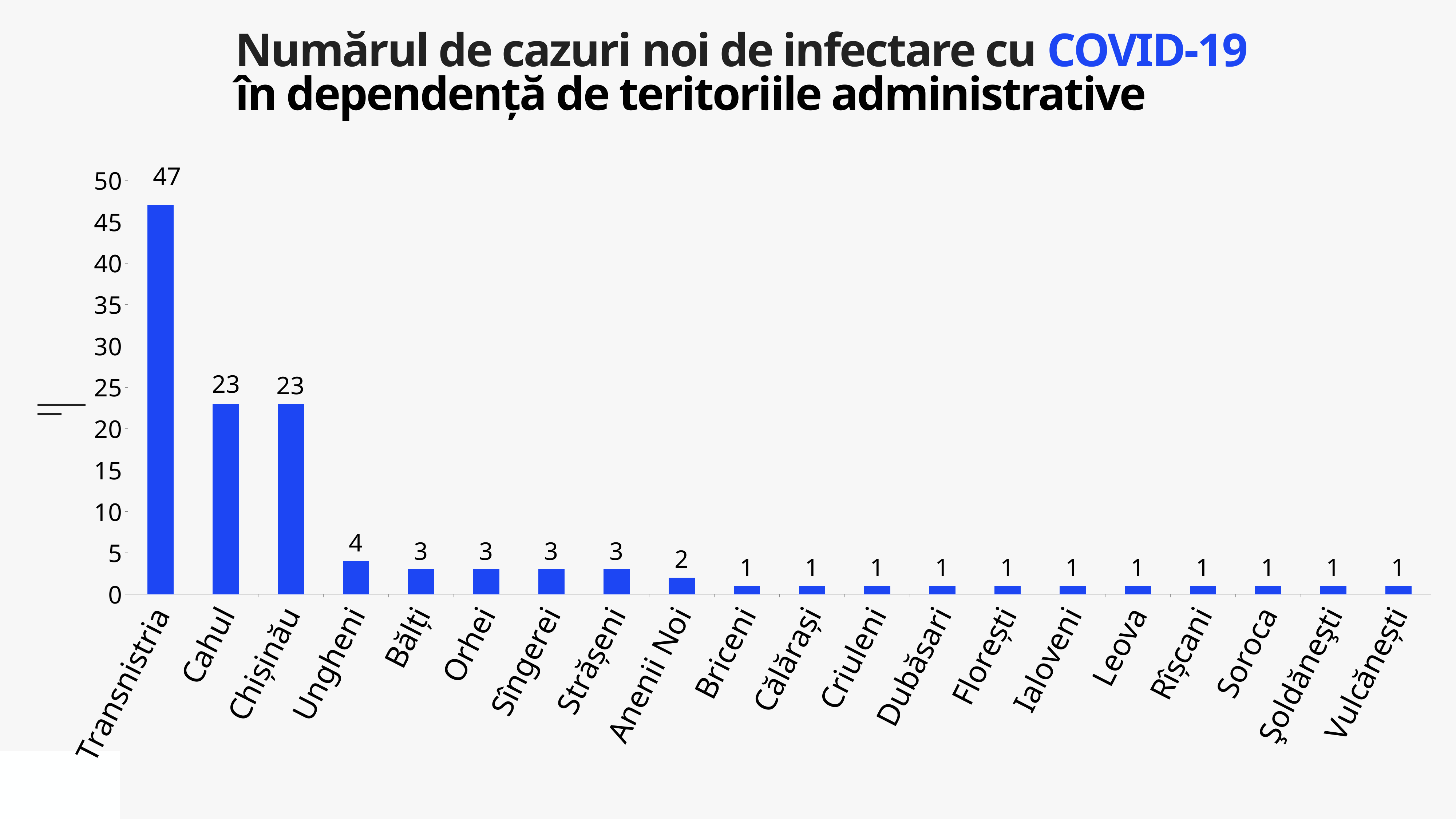
What is the value for Transnistria? 47 What is the value for Anenii Noi? 2 What kind of chart is shown on the slide? bar chart Is the value for Transnistria greater or less than 40? greater Which category has the highest value? Transnistria What is the value for Chișinău? 23 What is the value for Ungheni? 4 What is the difference between the values for Transnistria and Cahul? 24 What is the difference between the values for Ungheni and Bălți? 1 Which is larger, the value for Cahul or the value for Ungheni? Cahul Do the values rise or fall from left to right along the x axis? fall How many categories are shown on the x axis? 20